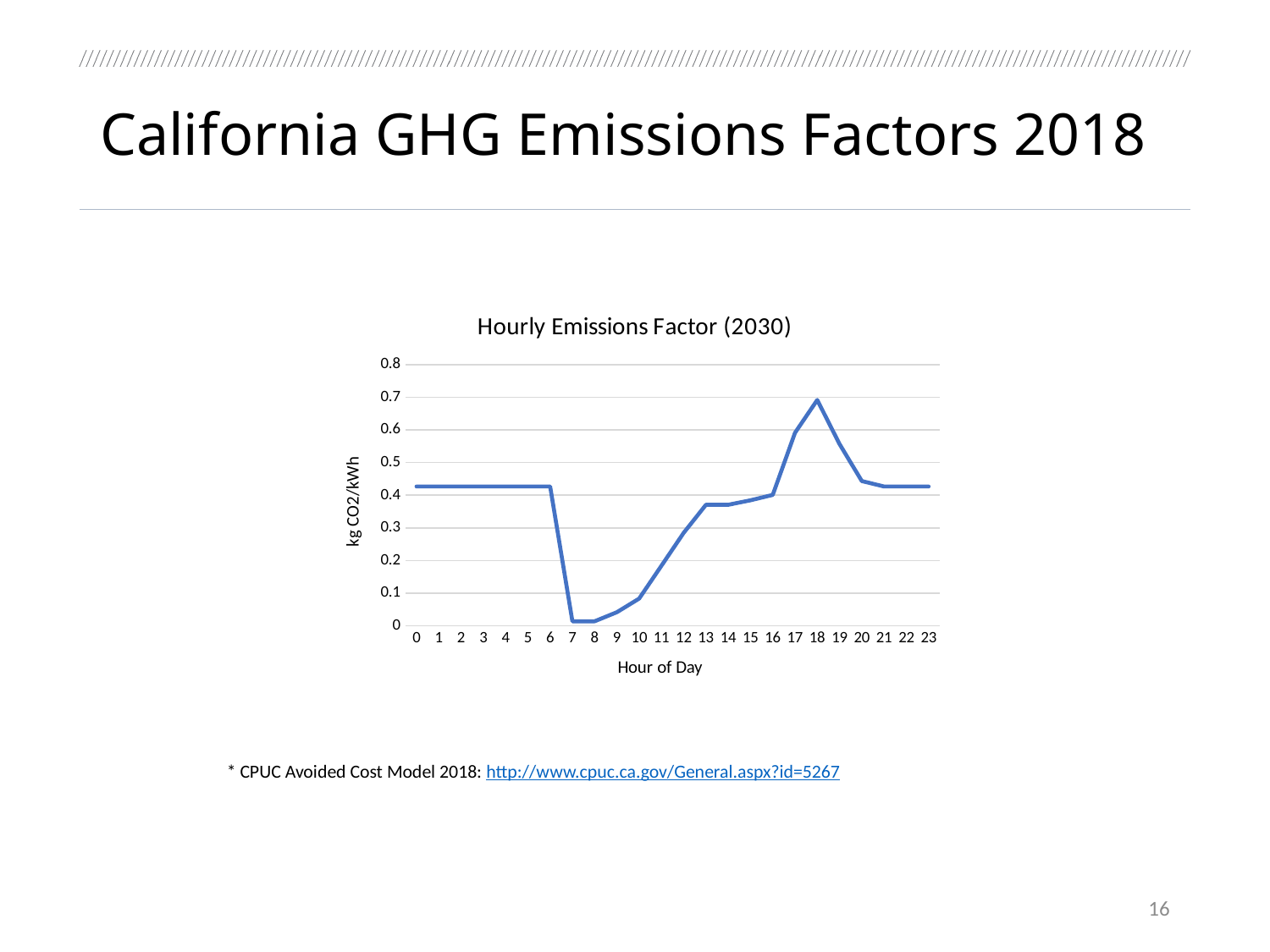
How many hours are plotted along the x axis of the chart? 24 What is the title of the chart? Hourly Emissions Factor (2030) Is the value at hour 18 greater or less than 0.6? greater Which has the larger value, hour 16 or hour 17? Hour 17 What is the label on the vertical axis of the chart? kg CO2/kWh Does the emissions factor rise or fall between hour 13 and hour 18? Rise Which has the larger value, hour 7 or hour 13? Hour 13 Is the value at hour 7 greater or less than 0.1? less Is the value at hour 12 greater or less than 0.4? less At which hour of the day does the emissions factor reach its highest value? 18 What kind of chart is shown on the slide? Line chart